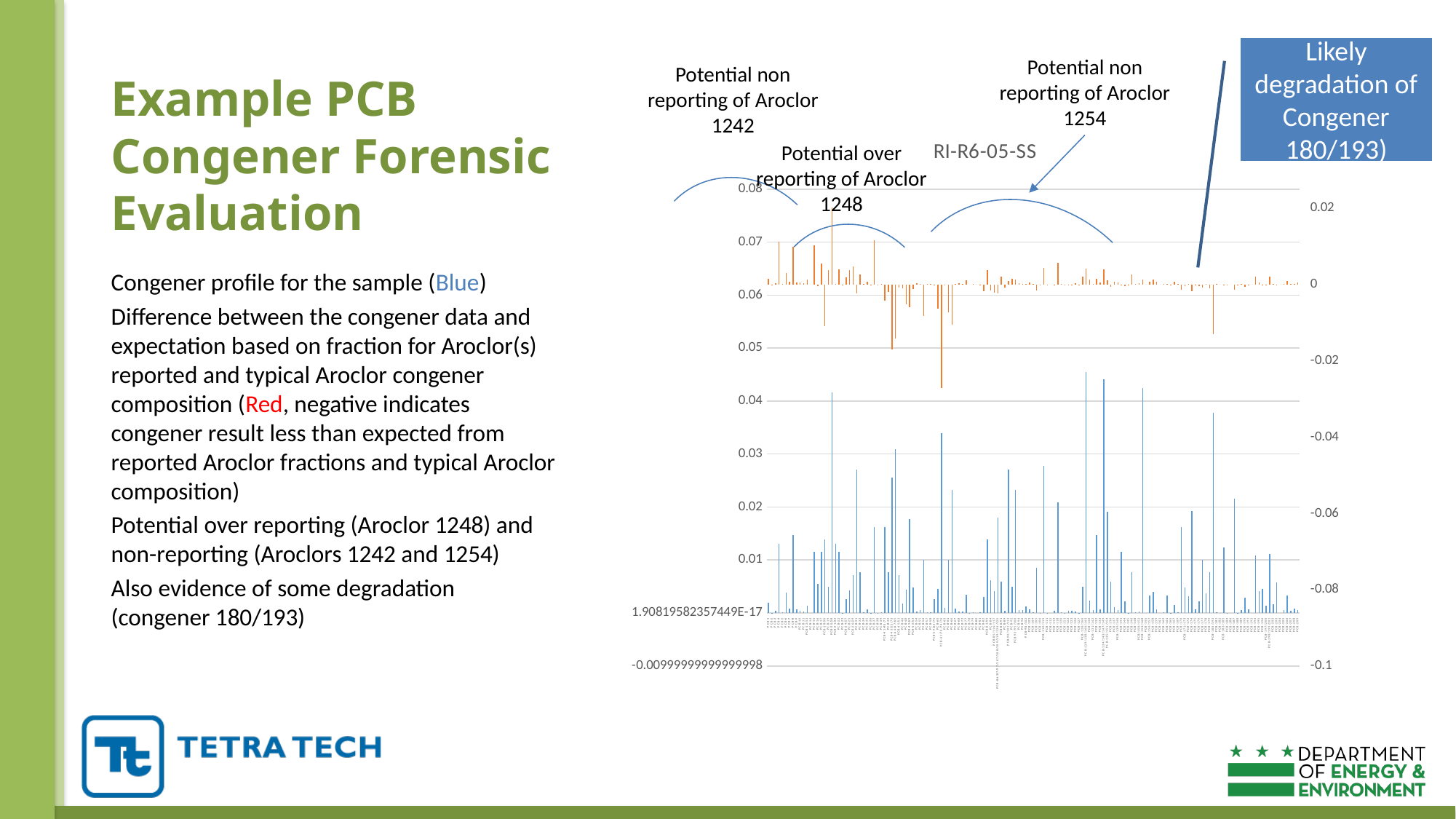
Is the tallest blue bar in the chart greater or less than 0.04 on the left axis? greater Which Aroclor does the chart annotation flag as potentially over reported? Aroclor 1248 Is the tallest blue bar in the chart greater or less than 0.05 on the left axis? less Is the most negative orange bar in the chart greater or less than -0.02 on the right axis? less What kind of chart is shown on the slide? bar chart What is the title of the chart? RI-R6-05-SS